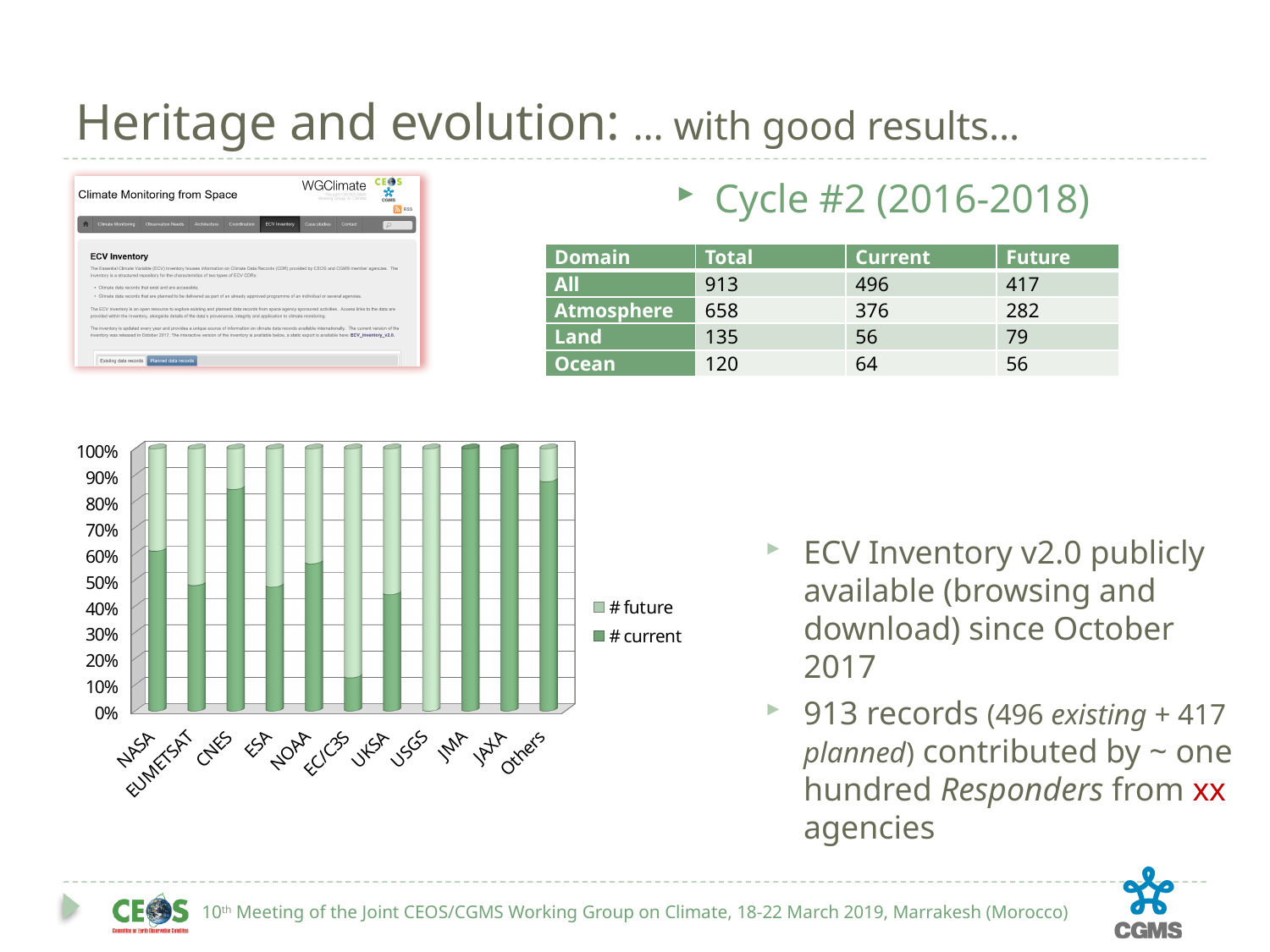
Which agency has the lowest share of # current records in the chart? USGS How many series does the chart legend list? 2 Is the # current share for NASA greater or less than 50%? greater How many agency categories are shown on the x axis of the chart? 11 Is the # current share for JMA greater or less than 90%? greater Is the # current share for EC/C3S greater or less than 20%? less Which has the larger # current share, NASA or EUMETSAT? NASA Which has the larger # future share, EC/C3S or CNES? EC/C3S What kind of chart is shown on the slide? stacked bar chart What are the two series named in the chart legend? # future and # current